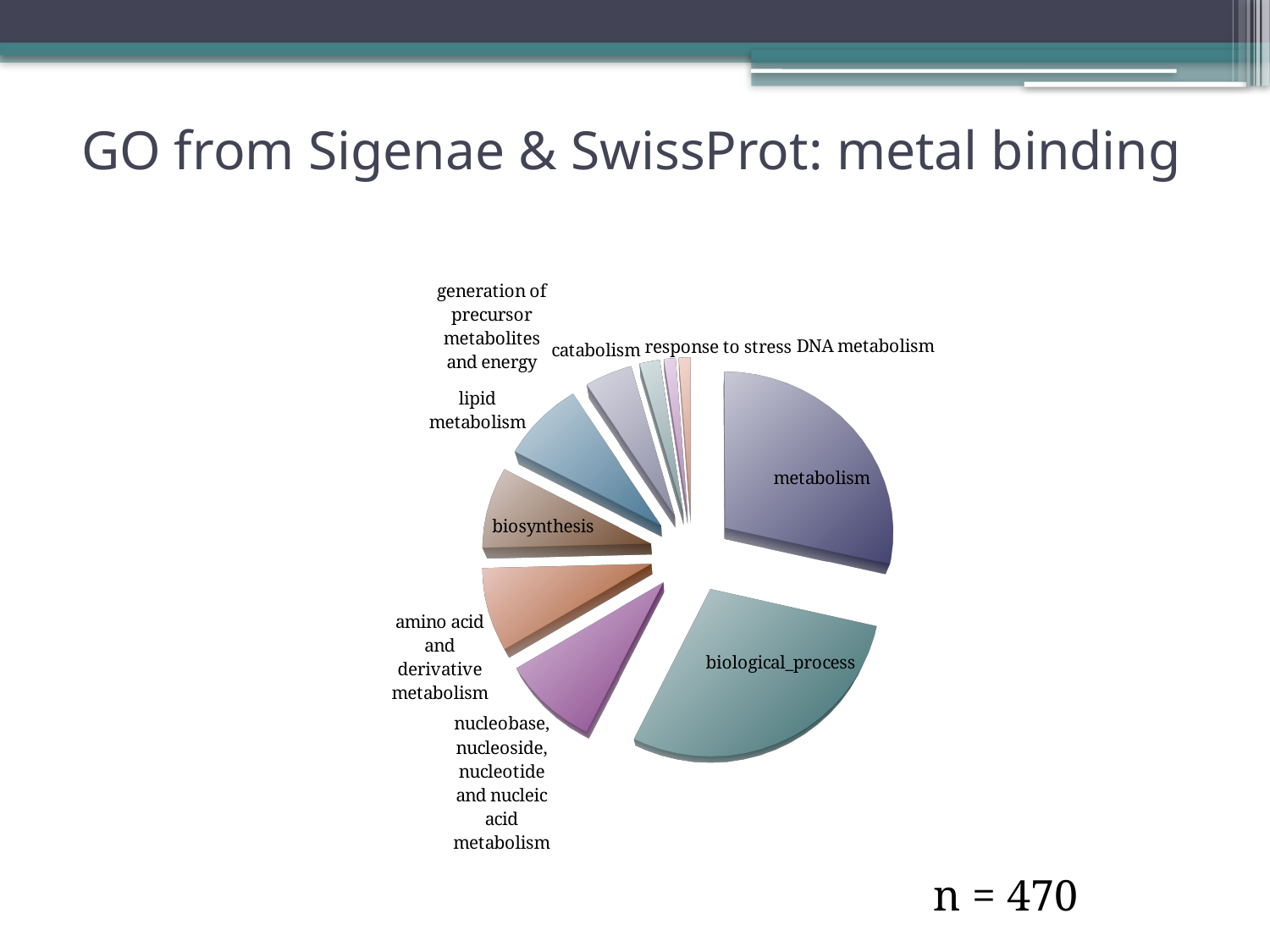
What is the title of the slide containing the pie chart? GO from Sigenae & SwissProt: metal binding How many slices does the pie chart have? 10 Which is larger in the pie chart, the biological_process slice or the response to stress slice? biological_process Which is larger in the pie chart, the metabolism slice or the catabolism slice? metabolism What kind of chart is shown on the slide? pie chart Which is larger in the pie chart, the amino acid and derivative metabolism slice or the catabolism slice? amino acid and derivative metabolism What sample size (n) is stated below the pie chart? n = 470